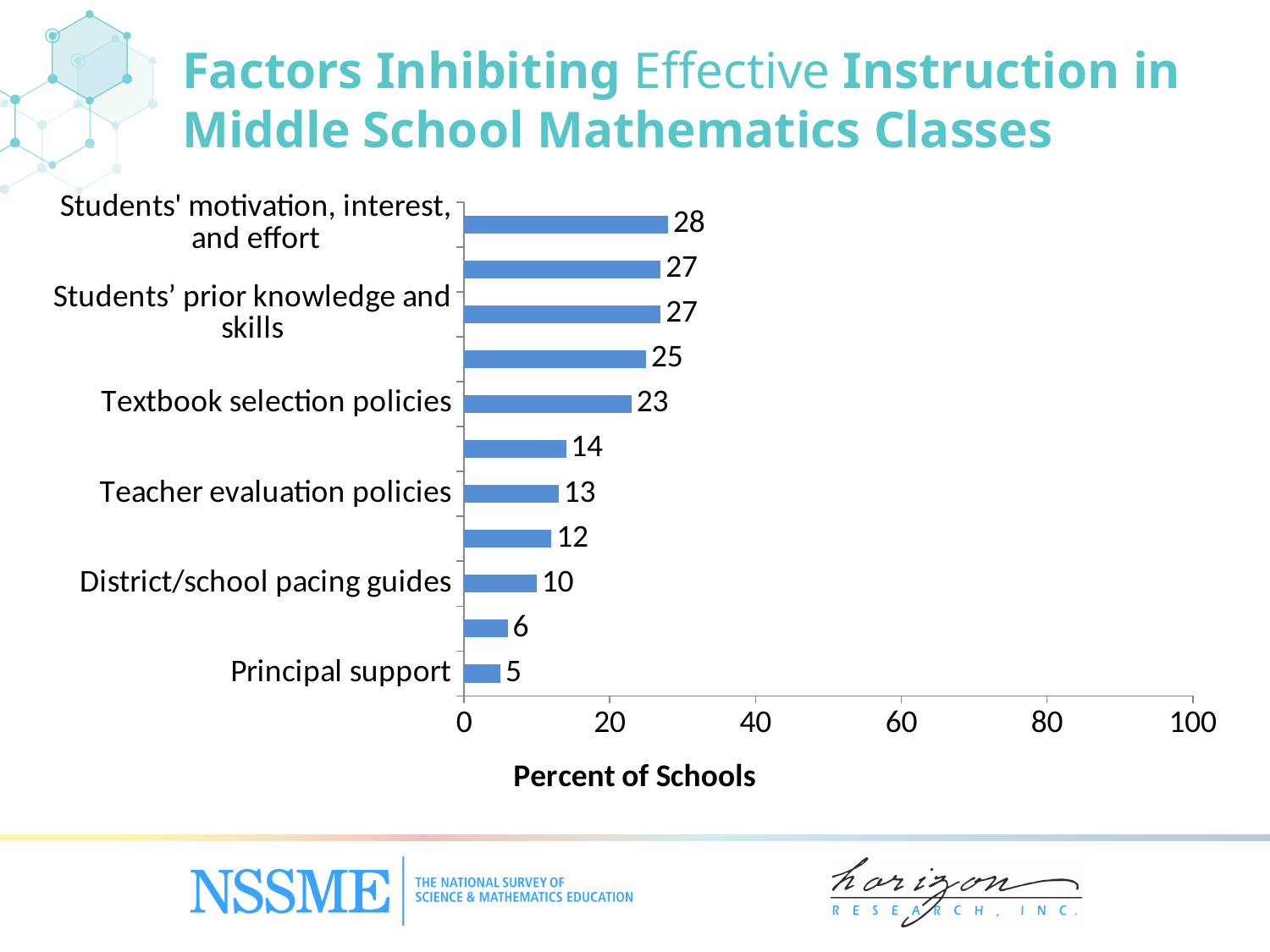
What is the label of the horizontal axis? Percent of Schools Which labeled factor has the highest percent of schools? Students' motivation, interest, and effort Which is larger, the value for Students' prior knowledge and skills or the value for District/school pacing guides? Students' prior knowledge and skills What is the difference between the values for Textbook selection policies and Teacher evaluation policies? 10 What is the value for District/school pacing guides? 10 What is the value for Teacher evaluation policies? 13 How many bars are plotted in the chart? 11 What percent of schools reported Students' motivation, interest, and effort as a factor? 28 Which labeled factor has the lowest percent of schools? Principal support What kind of chart is shown on the slide? bar chart What is the value for Textbook selection policies? 23 What is the value for Principal support? 5